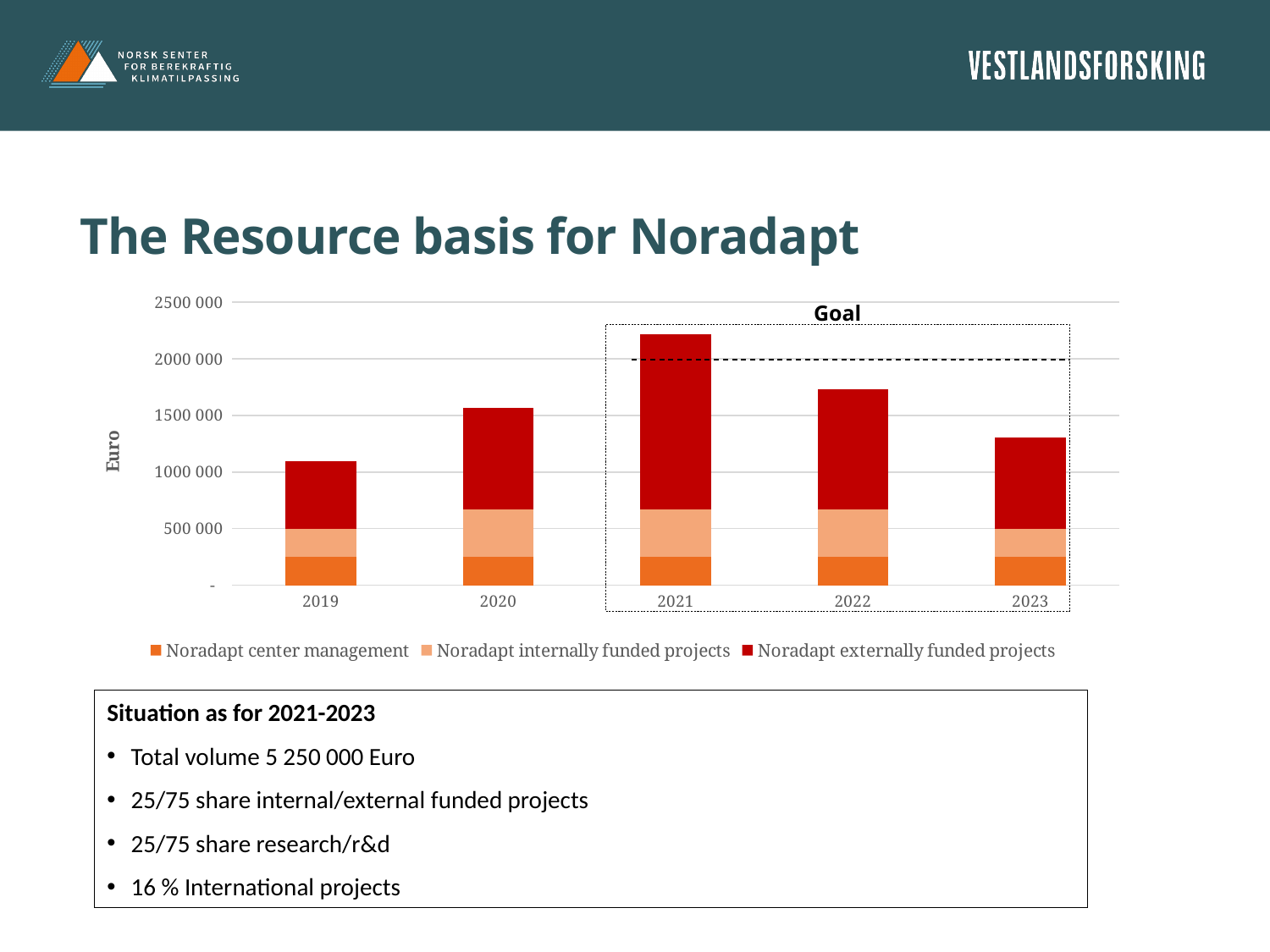
Do the total bars rise or fall from 2021 to 2023? fall What kind of chart is shown on the slide? Stacked bar chart Is the total bar for 2019 greater or less than 1000 000 Euro? greater Is the total bar for 2022 greater or less than 2000 000 Euro? less Which year has a larger total bar, 2020 or 2023? 2020 How many years are shown on the x axis of the chart? 5 Which year has the highest total bar in the chart? 2021 Is the total bar for 2023 greater or less than 1500 000 Euro? less Which year has the lowest total bar in the chart? 2019 How many series does the chart legend list? 3 What is the label on the y axis of the chart? Euro